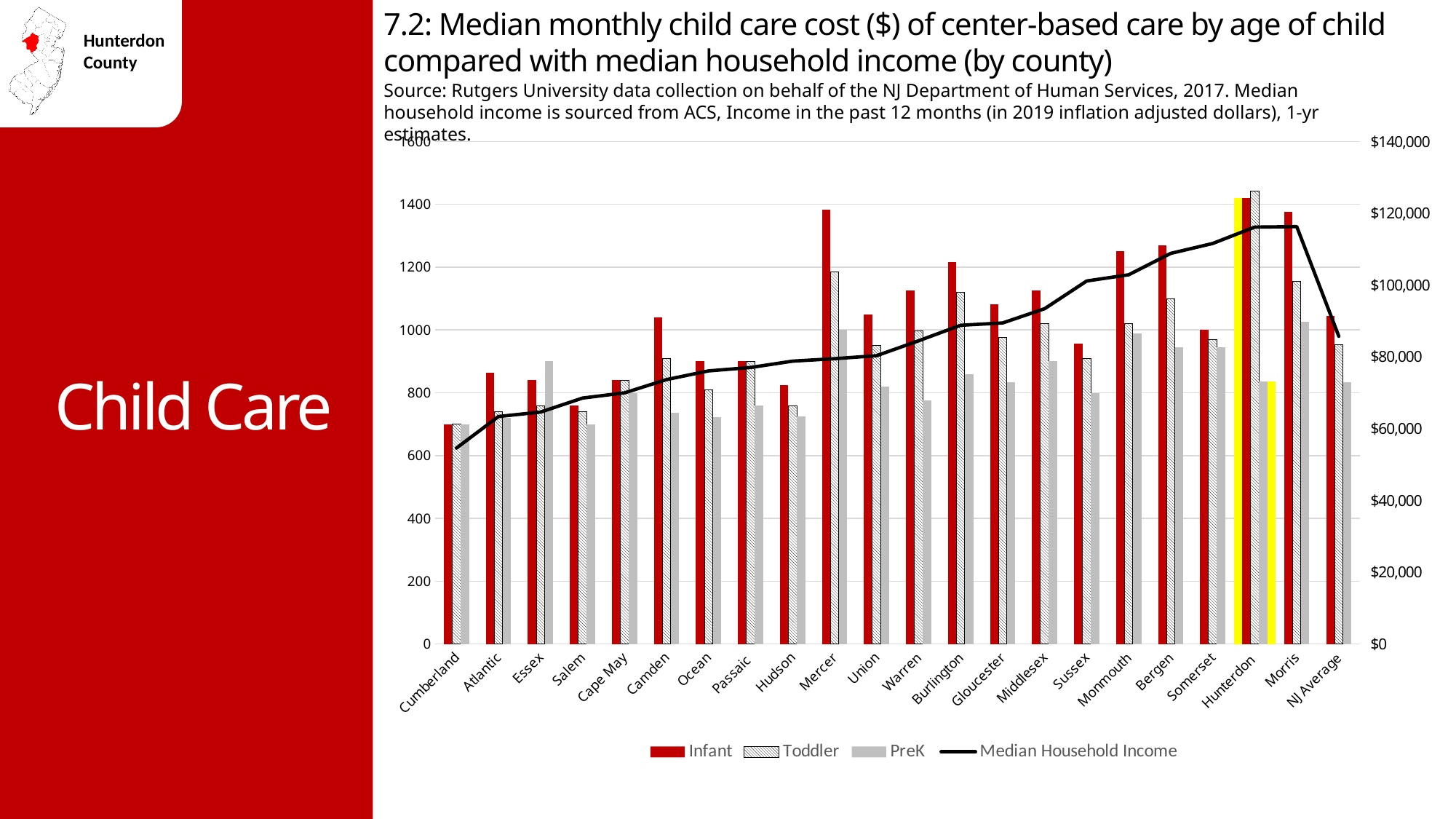
Is the Median Household Income for Morris greater or less than $100,000? greater Is the Infant value for Cumberland greater or less than 800? less Is the Median Household Income for Cumberland greater or less than $60,000? less Which is larger for Essex, the Infant value or the PreK value? PreK Which category has the lowest Infant value? Cumberland How many series does the legend list? 4 How many counties/categories are shown along the x axis? 22 Which county's bars are highlighted in yellow? Hunterdon What kind of chart is this? Bar chart with a line Which category has the highest Toddler value? Hunterdon Does the Median Household Income line generally rise or fall from Cumberland to Morris? rise